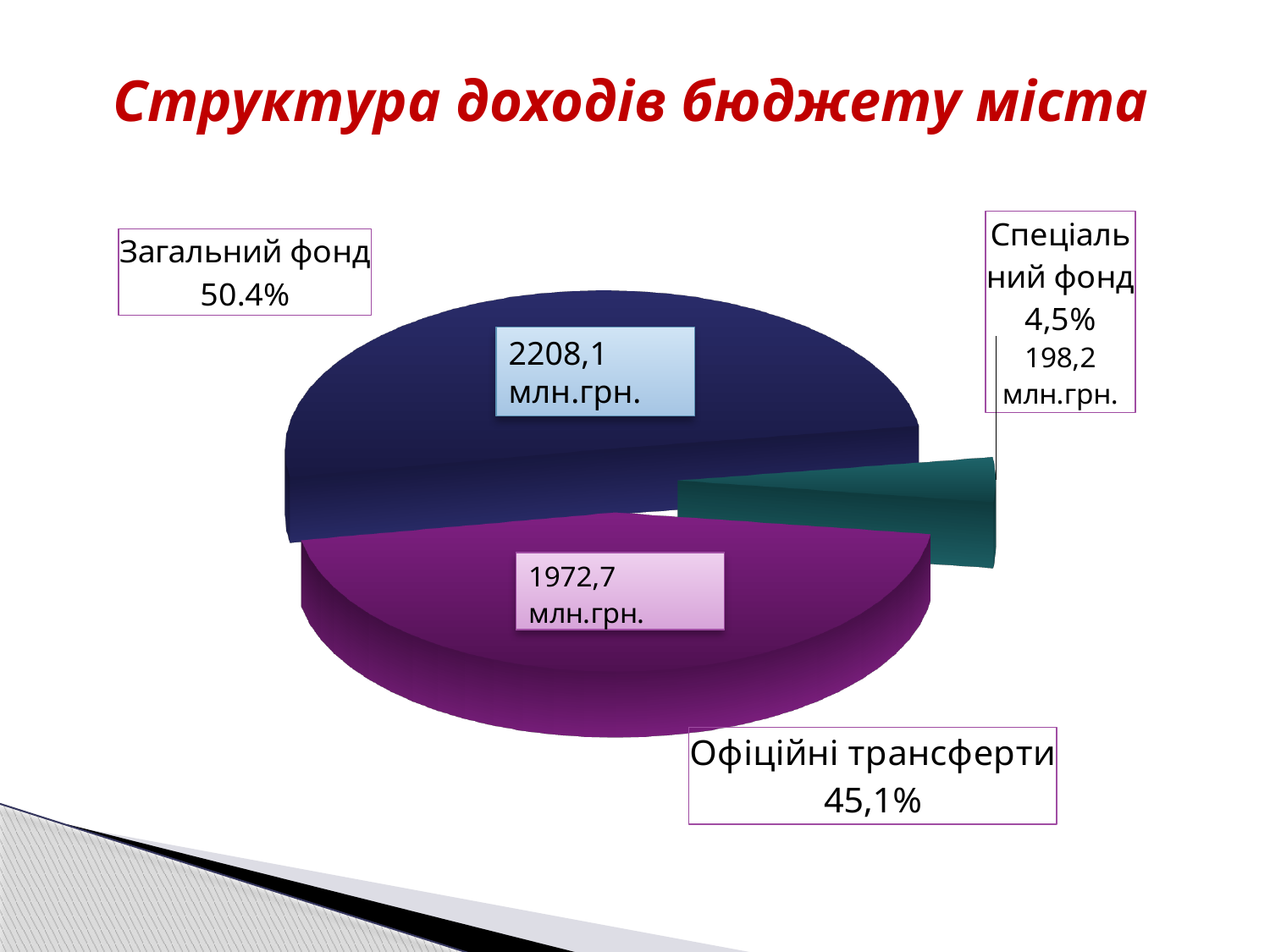
What is the value shown for Спеціальний фонд? 198,2 млн.грн. Which slice is the smallest? Спеціальний фонд What share of the pie does Спеціальний фонд represent? 4,5% What is the difference in млн.грн. between Загальний фонд and Офіційні трансферти? 235,4 млн.грн. What share of the pie does Офіційні трансферти represent? 45,1% What kind of chart is shown on the slide? Pie chart What is the value shown for Офіційні трансферти? 1972,7 млн.грн. What is the value shown for Загальний фонд? 2208,1 млн.грн. Which slice is the largest? Загальний фонд What is the title of the chart? Структура доходів бюджету міста How many slices does the pie chart have? 3 What share of the pie does Загальний фонд represent? 50.4%